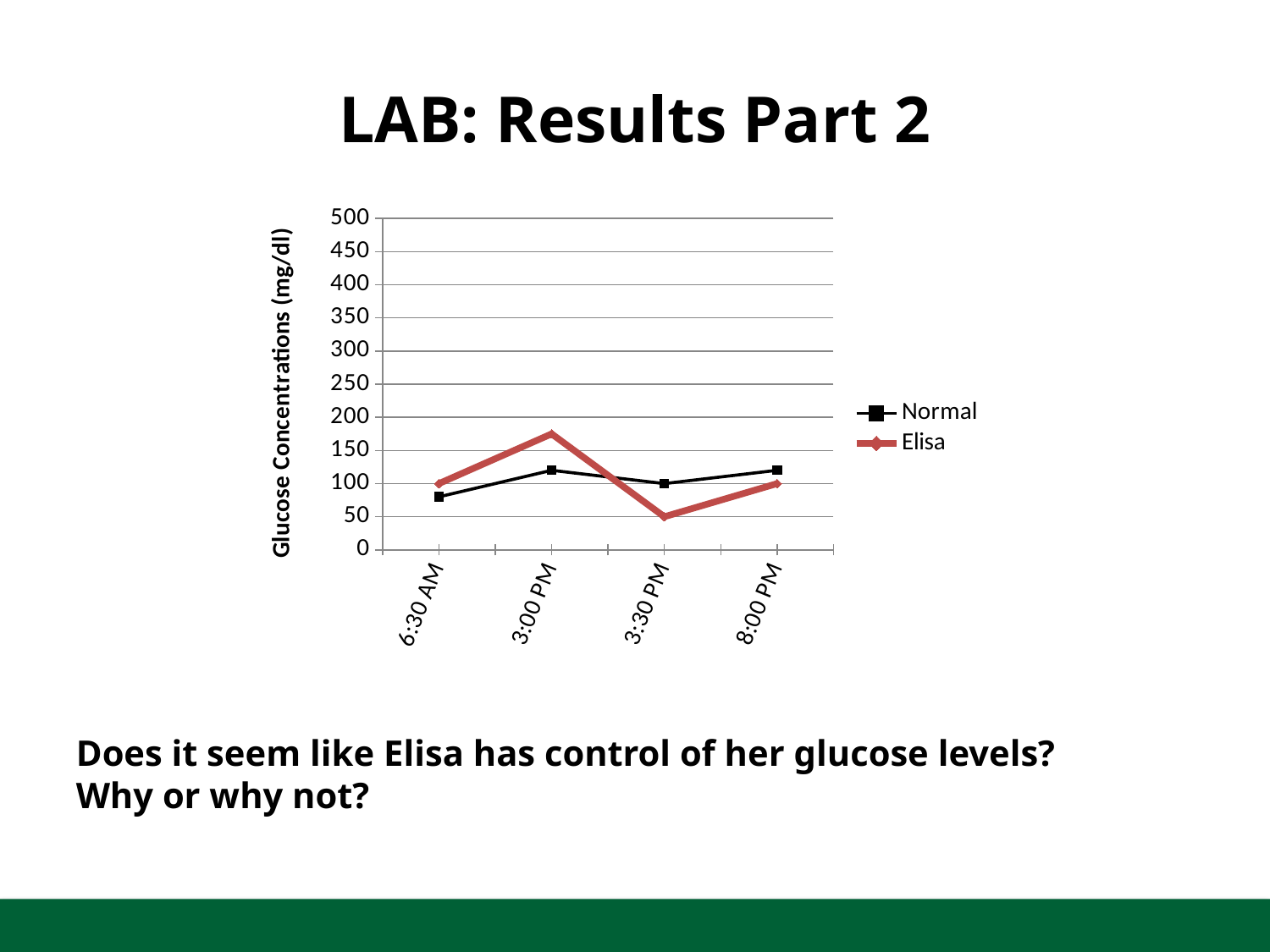
How many series does the legend list? 2 How many time points are plotted along the x axis? 4 At 3:00 PM, which series has the higher glucose concentration, Normal or Elisa? Elisa What kind of chart is shown on the slide? line chart What is the Normal glucose concentration at 3:30 PM? 100 At which time is Elisa's glucose concentration lowest? 3:30 PM What is Elisa's glucose concentration at 3:30 PM? 50 Is the Normal value at 6:30 AM greater or less than 100? less Is Elisa's value at 3:00 PM greater or less than 150? greater At which time is Elisa's glucose concentration highest? 3:00 PM What is the label on the y axis? Glucose Concentrations (mg/dl) What is Elisa's glucose concentration at 6:30 AM? 100